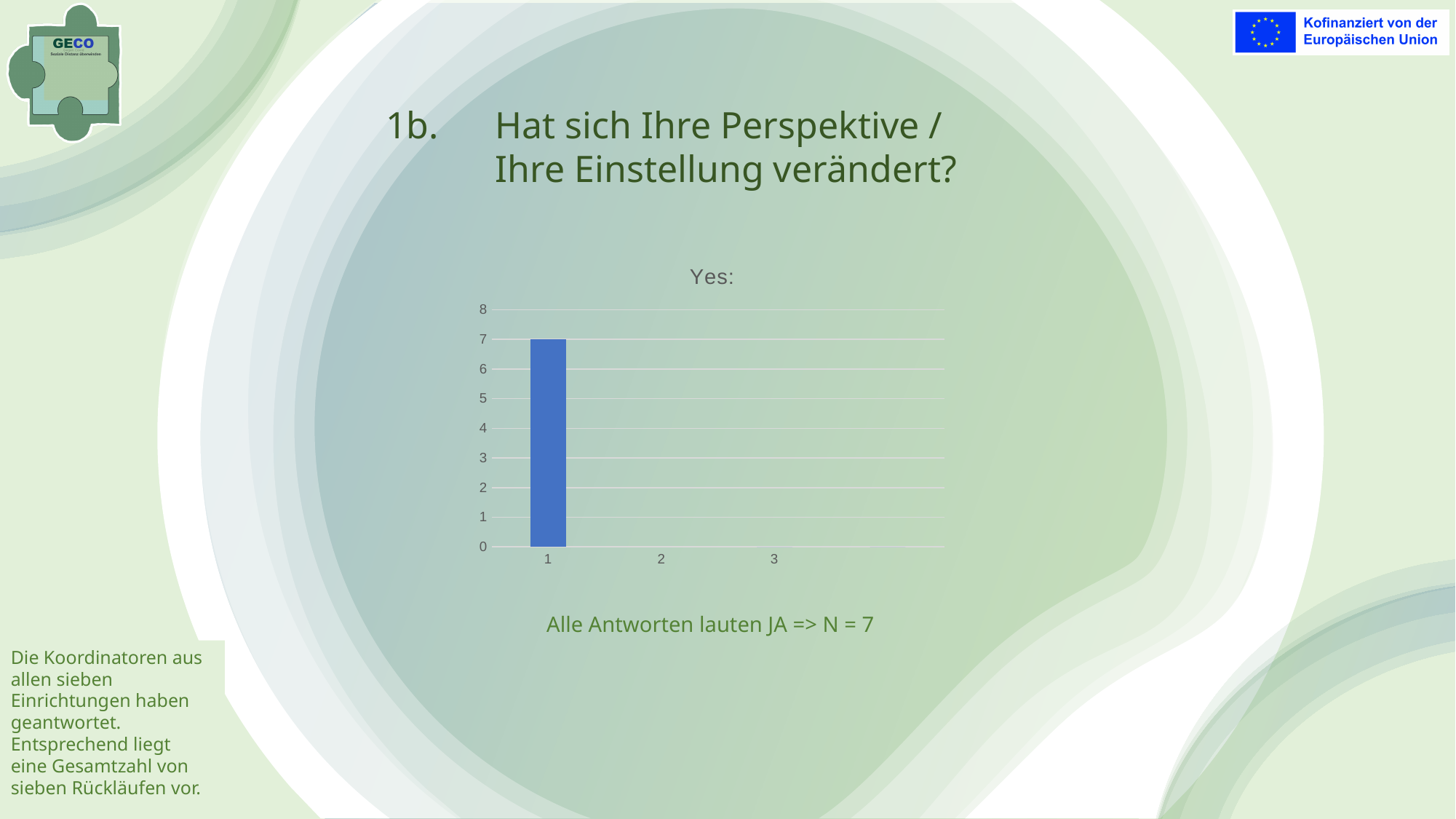
Is the value for category 1 greater or less than 5? greater What is the highest value shown on the y axis? 8 What is the title of the chart? Yes: What is the value of the bar for category 1? 7 Is the value for category 1 greater or less than 8? less How many bars are plotted in the chart? 1 What kind of chart is shown on the slide? bar chart How many category labels are shown on the x axis? 3